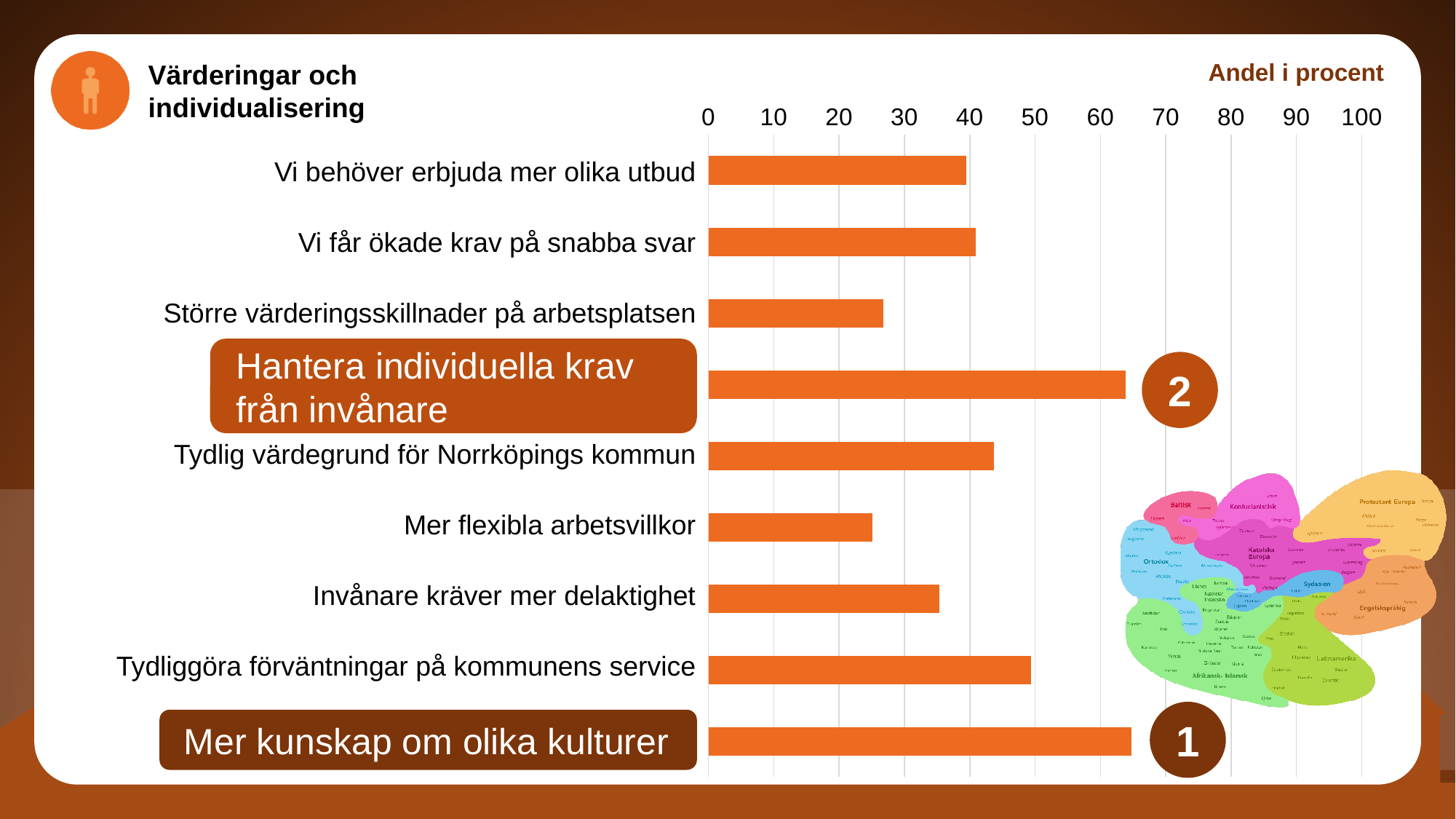
How many categories (bars) does the chart show? 9 Is the value for "Hantera individuella krav från invånare" greater or less than 60? greater What is the title of the chart? Värderingar och individualisering Which is larger: the value for "Hantera individuella krav från invånare" or for "Tydlig värdegrund för Norrköpings kommun"? Hantera individuella krav från invånare What kind of chart is shown on the slide? bar chart What unit label is shown above the value axis? Andel i procent Is the value for "Mer kunskap om olika kulturer" greater or less than 60? greater Which is larger: the value for "Tydliggöra förväntningar på kommunens service" or for "Invånare kräver mer delaktighet"? Tydliggöra förväntningar på kommunens service Is the value for "Tydliggöra förväntningar på kommunens service" greater or less than 40? greater